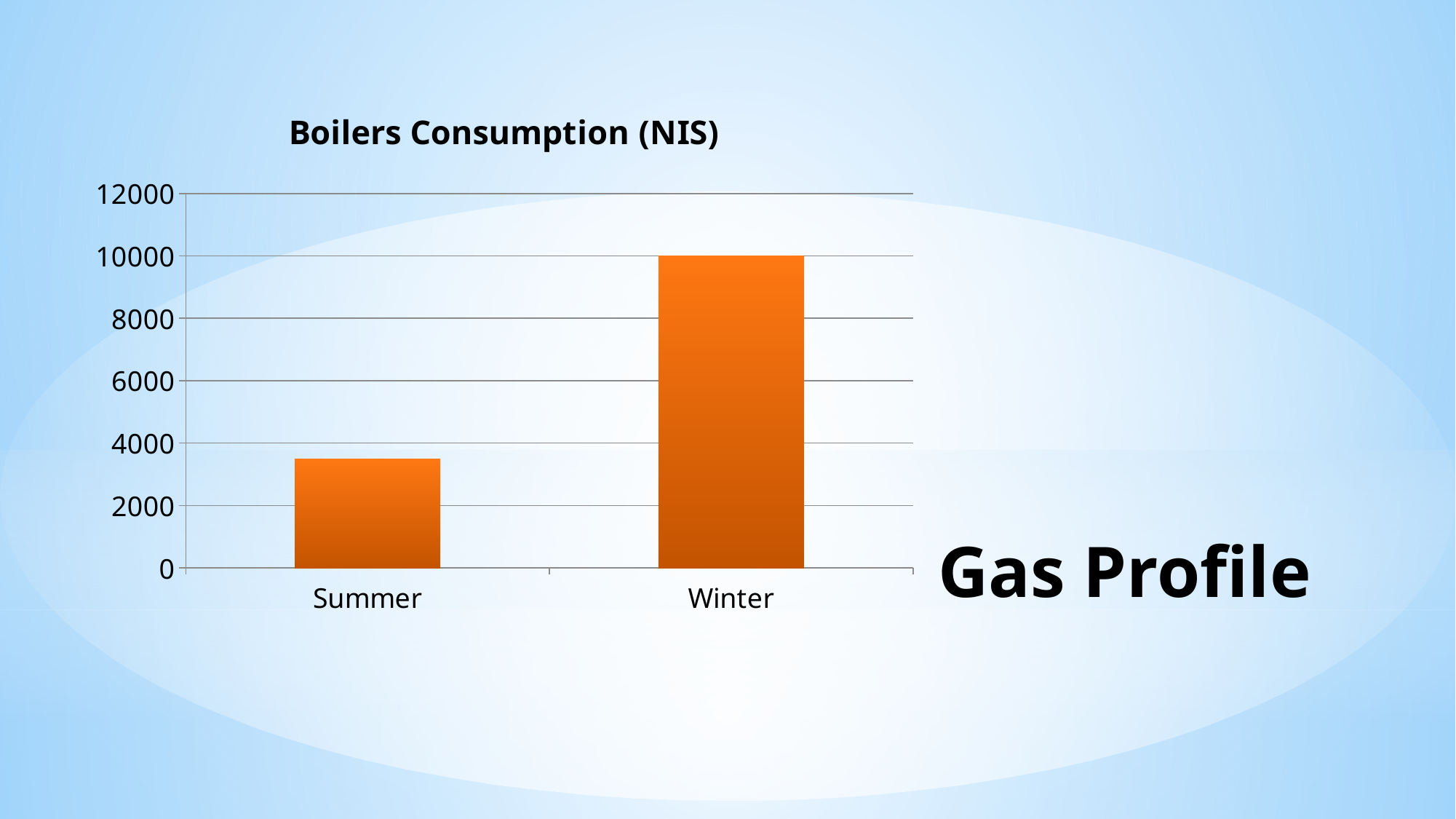
Which category has the highest boilers consumption? Winter What is the title of the chart? Boilers Consumption (NIS) Do the values rise or fall from Summer to Winter along the x axis? rise What is the boilers consumption value for Winter? 10000 Which is larger, the boilers consumption for Summer or for Winter? Winter How many categories are plotted in the chart? 2 Which category has the lowest boilers consumption? Summer Is the value for Summer greater or less than 2000? greater What colour are the bars in the chart? orange Is the value for Summer greater or less than 4000? less Is the value for Winter greater or less than 8000? greater What kind of chart is shown on the slide? bar chart